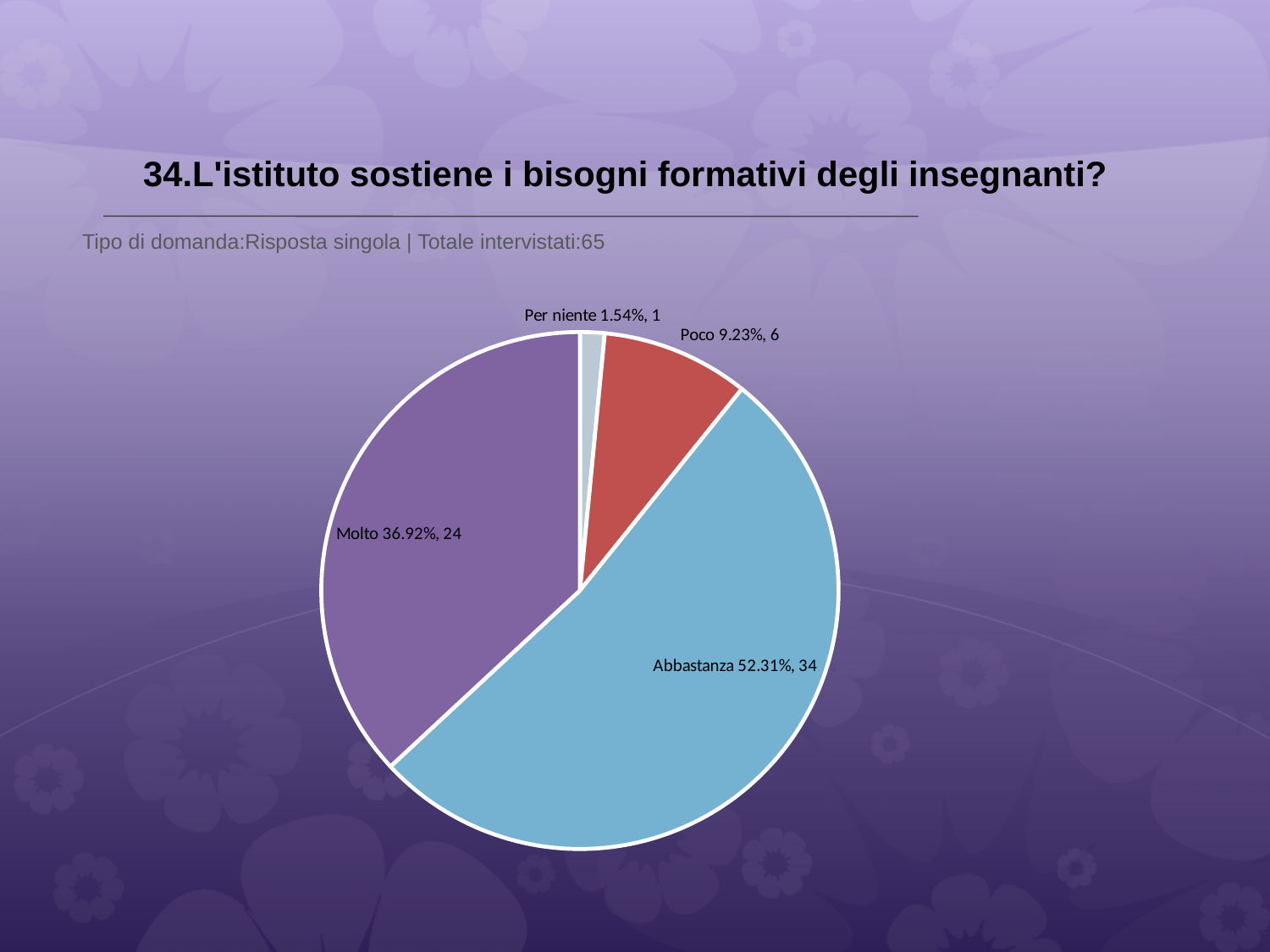
What percentage share does the Abbastanza slice have? 52.31% How many respondents answered Per niente? 1 What is the difference in respondent count between Abbastanza and Molto? 10 How many slices does the pie chart have? 4 Which has more respondents, Poco or Molto? Molto Which category has the largest slice? Abbastanza What is the total number of respondents shown in the subtitle? 65 What kind of chart is shown on the slide? pie chart Which category has the smallest slice? Per niente What percentage share does the Poco slice have? 9.23% How many respondents answered Molto? 24 What colour is the Abbastanza slice? light blue